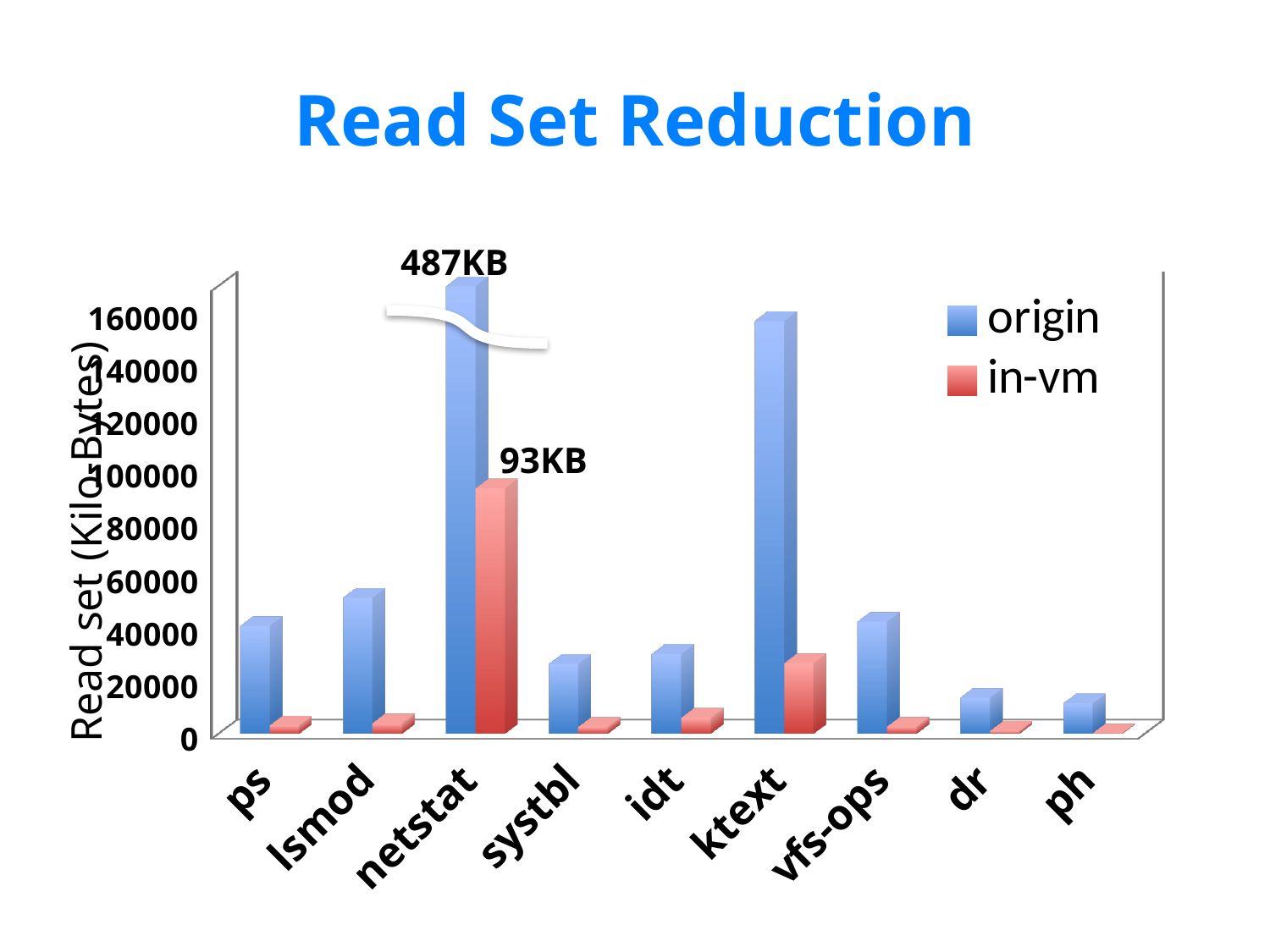
What is the difference between the origin and in-vm values for netstat? 394KB Which category has the highest origin value? netstat Which has the larger origin value, ps or lsmod? lsmod What is the labelled value of the origin bar for netstat? 487KB Is the origin value for ktext greater or less than 140000? greater How many categories are shown on the x axis? 9 What is the labelled value of the in-vm bar for netstat? 93KB Is the origin value for systbl greater or less than 40000? less How many series does the legend list? 2 What is the title of the chart? Read Set Reduction What kind of chart is shown on the slide? bar chart Which has the larger in-vm value, idt or ktext? ktext